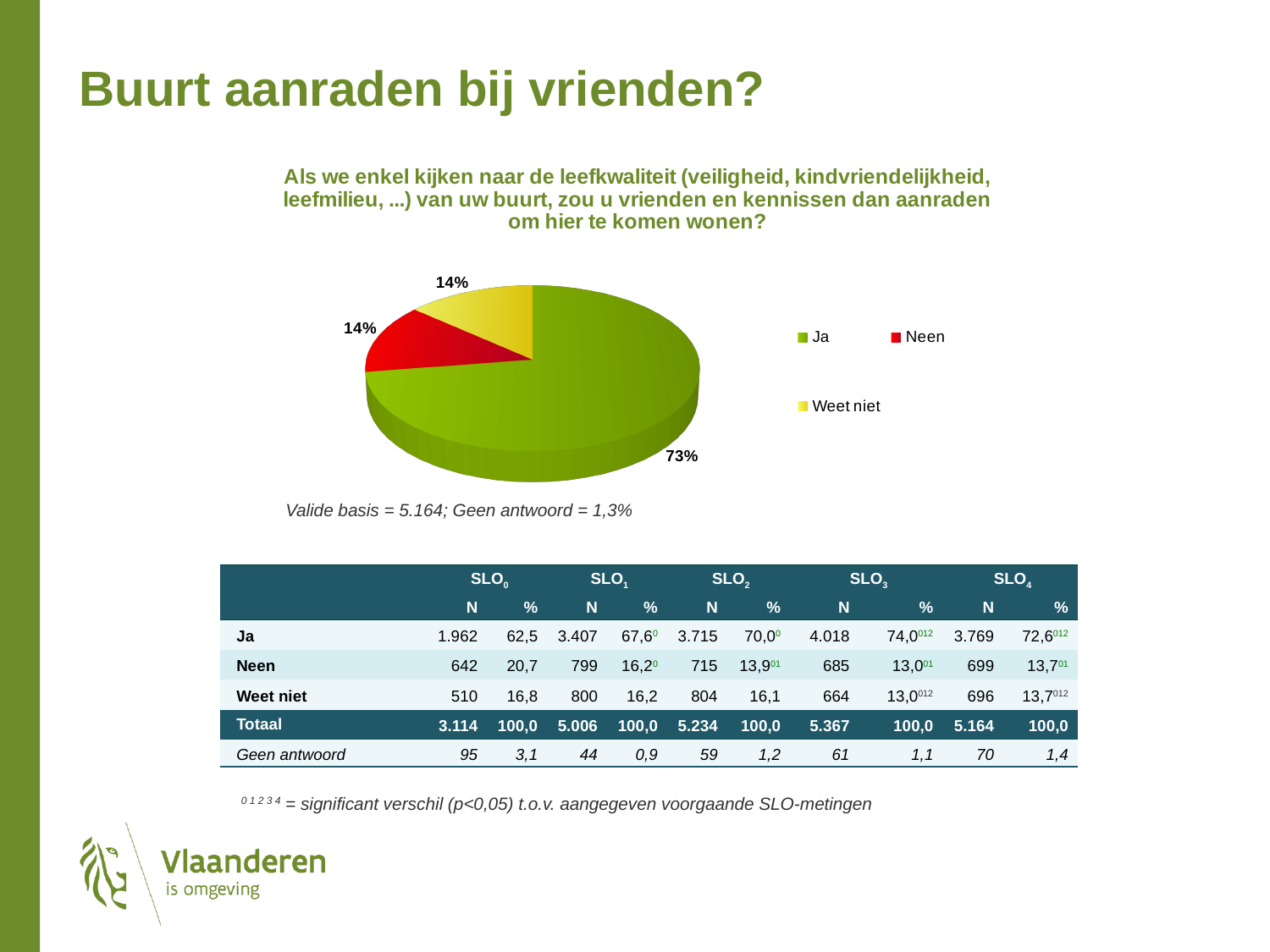
What kind of chart is shown on the slide? pie chart How many slices does the pie chart have? 3 Which is larger in the pie chart, the slice for "Ja" or the slice for "Neen"? Ja How many entries does the legend of the pie chart list? 3 By how many percentage points does the "Ja" slice exceed the "Neen" slice in the pie chart? 59 What share of the pie chart does the "Ja" slice represent? 73% What is the valid basis (Valide basis) stated below the pie chart? 5.164 What colour is the "Neen" slice in the pie chart? red What percentage of the pie chart is labelled for "Ja"? 73% Which category has the largest slice in the pie chart? Ja What percentage of the pie chart is labelled for "Weet niet"? 14% What percentage of the pie chart is labelled for "Neen"? 14%